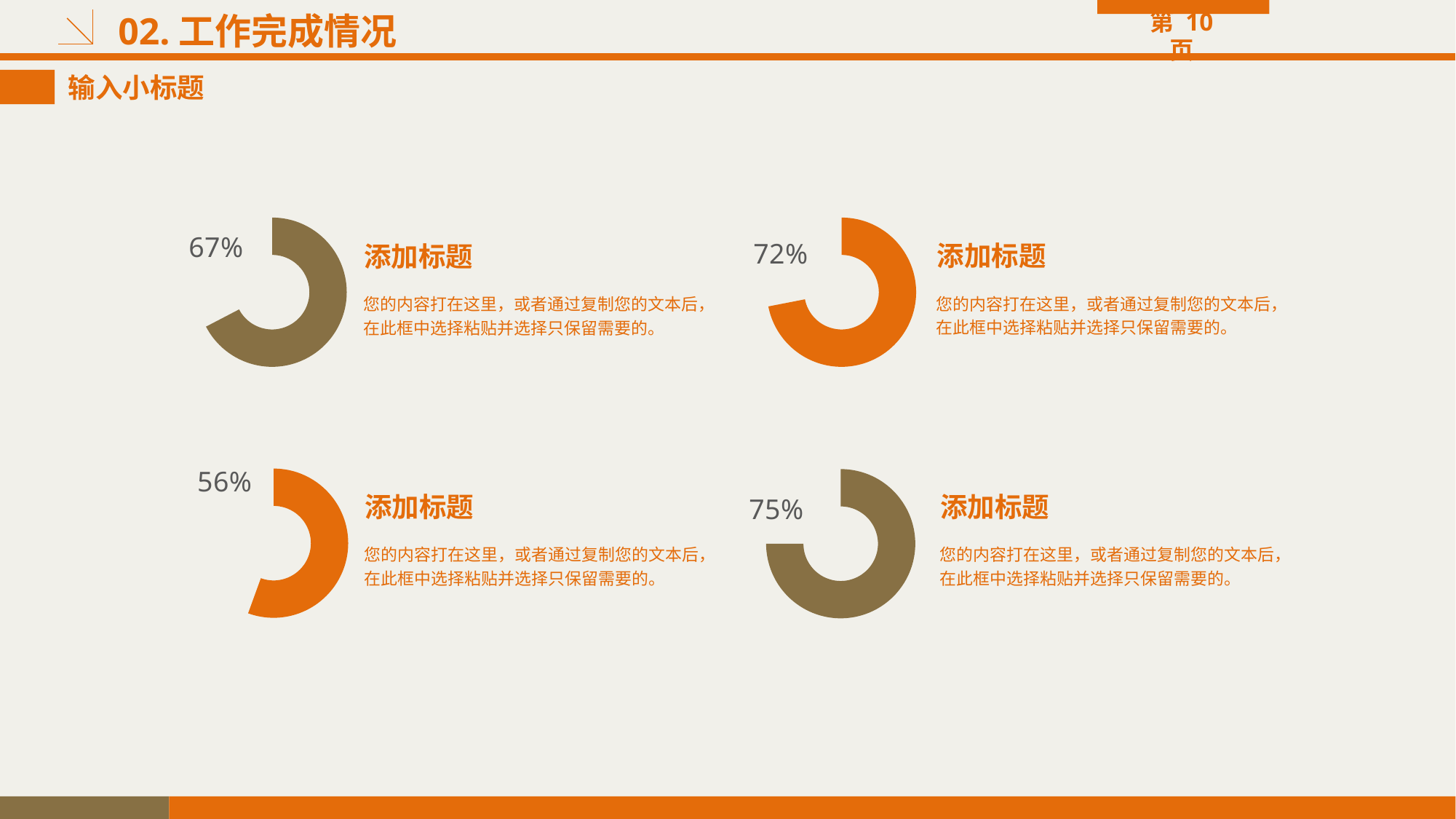
What kind of chart is used to show each percentage on the slide? doughnut chart Which is larger, the percentage in the top-left chart or the percentage in the top-right chart? top-right (72%) What percentage is shown by the top-left doughnut chart? 67% What percentage is shown by the bottom-right doughnut chart? 75% Which of the four doughnut charts shows the highest percentage? bottom-right (75%) What is the difference between the percentage in the bottom-right chart and the percentage in the bottom-left chart? 19% Which of the four doughnut charts shows the lowest percentage? bottom-left (56%) What is the difference between the percentage in the top-right chart and the percentage in the top-left chart? 5% What percentage is shown by the top-right doughnut chart? 72% What colour is the filled portion of the top-right doughnut chart? orange What percentage is shown by the bottom-left doughnut chart? 56% How many doughnut charts are on the slide? 4